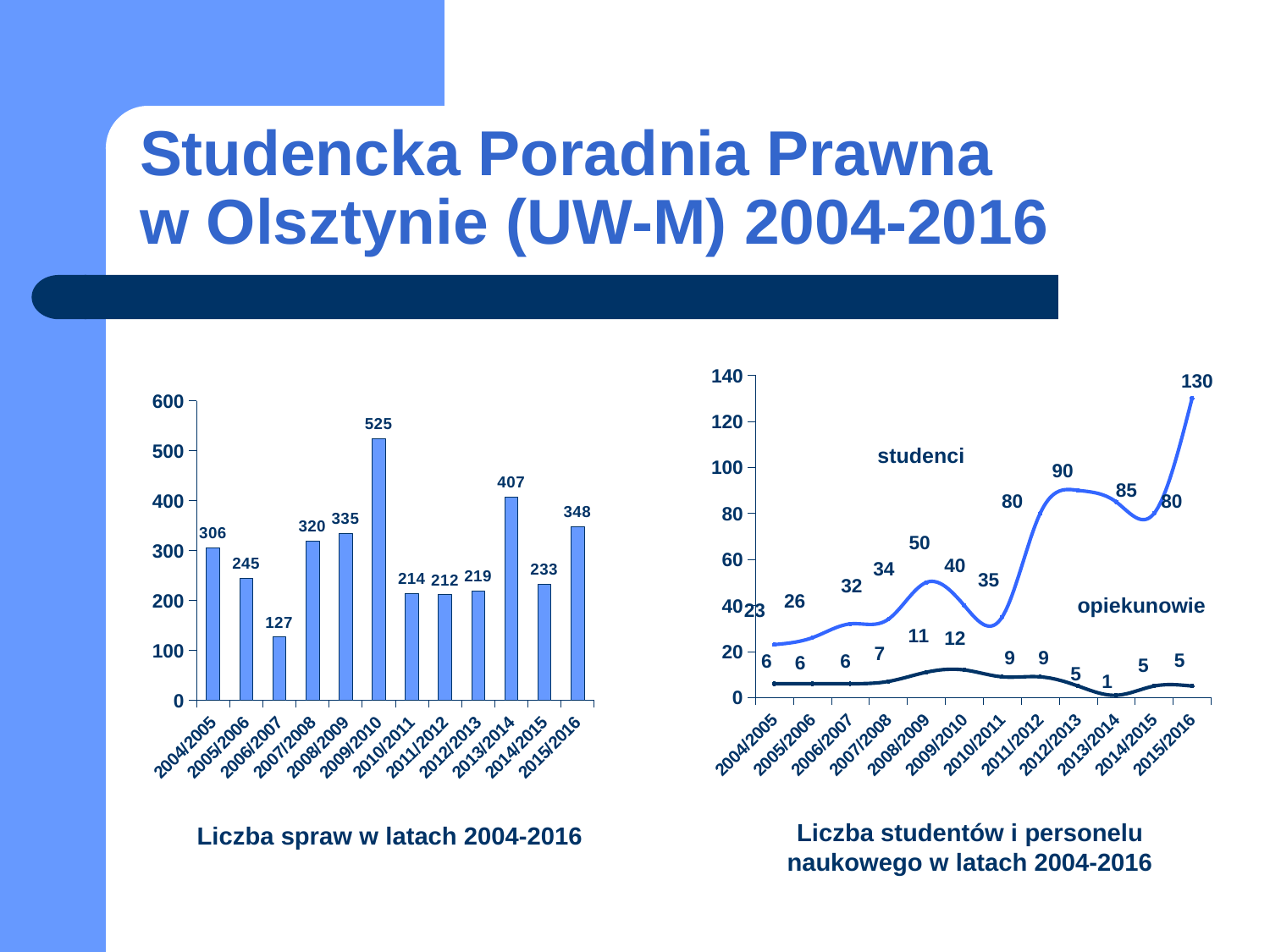
In the chart 'Liczba spraw w latach 2004-2016', what is the difference between the values for 2013/2014 and 2014/2015? 174 In the chart 'Liczba spraw w latach 2004-2016', which year has the highest value? 2009/2010 In the chart 'Liczba spraw w latach 2004-2016', which year has the lowest value? 2006/2007 In the chart 'Liczba spraw w latach 2004-2016', what is the value for 2009/2010? 525 What type of chart is 'Liczba studentów i personelu naukowego w latach 2004-2016'? line chart What type of chart is 'Liczba spraw w latach 2004-2016'? bar chart In the chart 'Liczba studentów i personelu naukowego w latach 2004-2016', what is the value for studenci in 2015/2016? 130 In the chart 'Liczba spraw w latach 2004-2016', how many years are shown on the x axis? 12 In the chart 'Liczba studentów i personelu naukowego w latach 2004-2016', how many series are plotted? 2 In the chart 'Liczba studentów i personelu naukowego w latach 2004-2016', what is the value for opiekunowie in 2013/2014? 1 In the chart 'Liczba studentów i personelu naukowego w latach 2004-2016', which year has the highest value for opiekunowie? 2009/2010 In the chart 'Liczba studentów i personelu naukowego w latach 2004-2016', what is the difference between studenci and opiekunowie in 2012/2013? 85